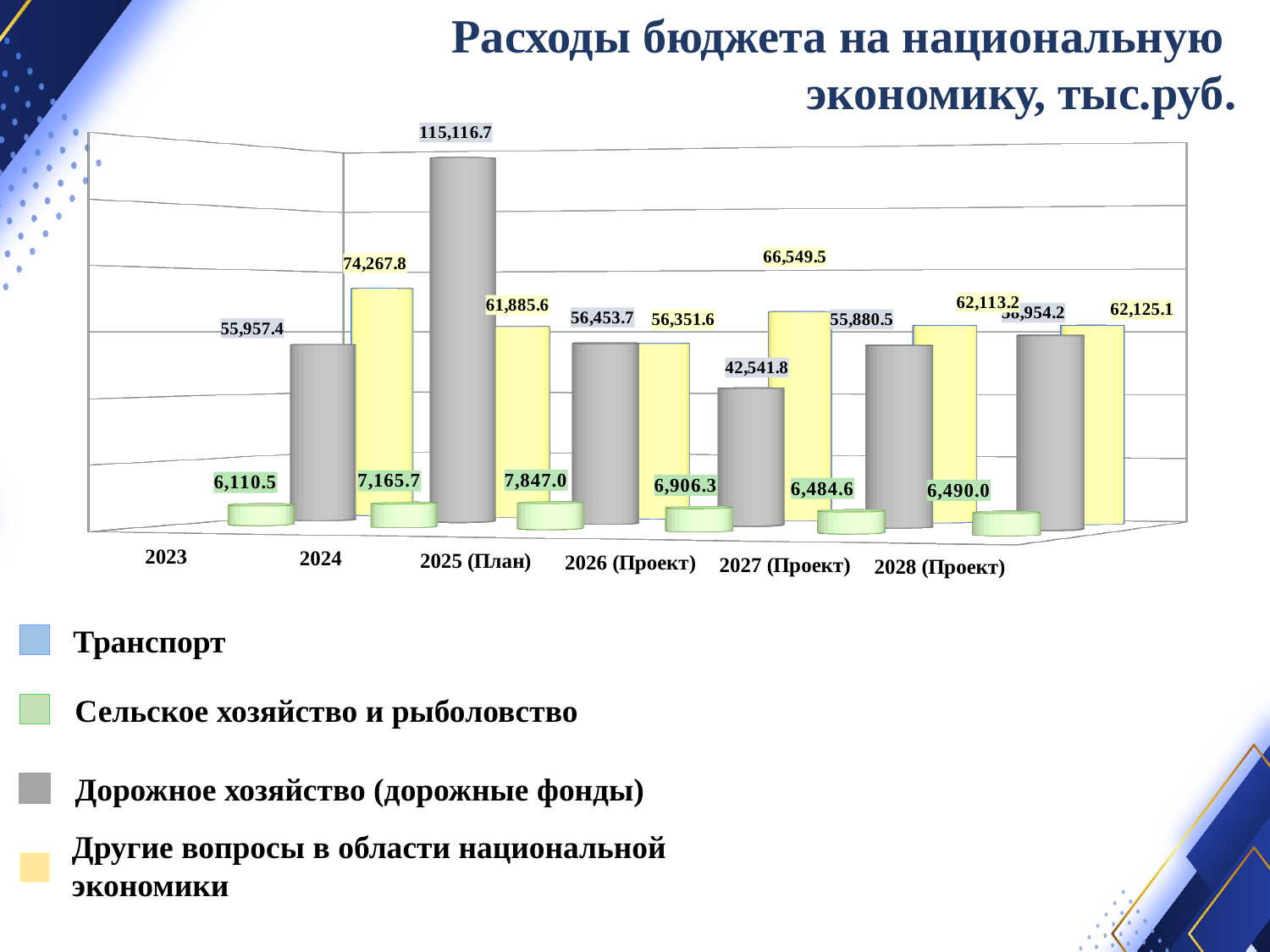
What is the title of the chart? Расходы бюджета на национальную экономику, тыс.руб. In which year is the value for Сельское хозяйство и рыболовство the lowest? 2023 What is the value for Дорожное хозяйство (дорожные фонды) in 2026 (Проект)? 42,541.8 What is the value for Другие вопросы в области национальной экономики in 2023? 74,267.8 In which year is the value for Дорожное хозяйство (дорожные фонды) the highest? 2024 In 2026 (Проект), which is larger: Дорожное хозяйство (дорожные фонды) or Другие вопросы в области национальной экономики? Другие вопросы в области национальной экономики How many categories (years) are shown on the x axis of the chart? 6 What is the value for Сельское хозяйство и рыболовство in 2025 (План)? 7,847.0 What kind of chart is shown on the slide? Bar chart In which year is the value for Другие вопросы в области национальной экономики the highest? 2023 What is the difference between the Дорожное хозяйство (дорожные фонды) values for 2024 and 2023? 59,159.3 How many series does the legend list? 4